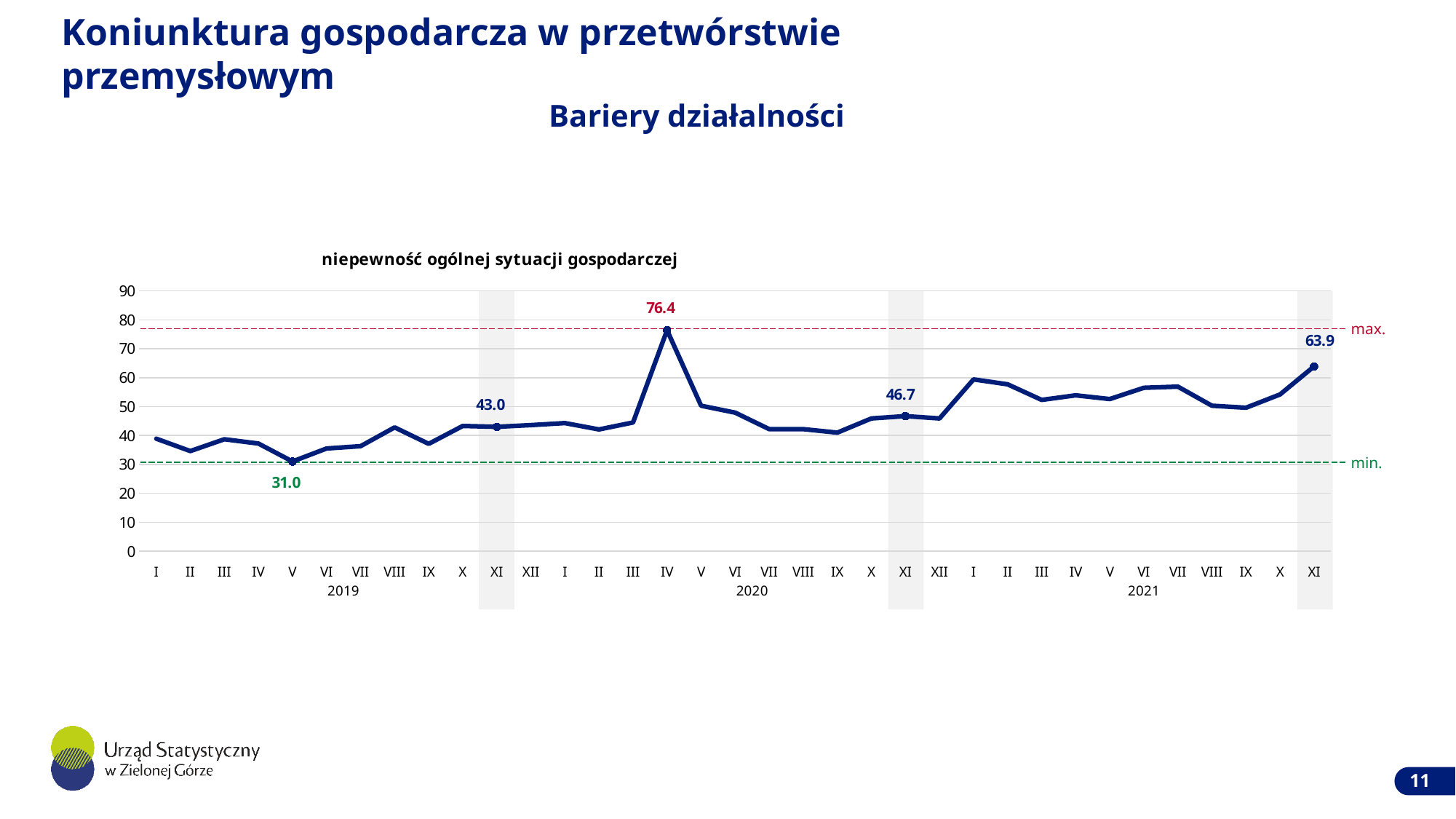
Which is larger, the value for XI 2019 or the value for XI 2020? XI 2020 What is the value for XI 2019? 43.0 What is the value for IV 2020? 76.4 What is the difference between the values for XI 2021 and XI 2020? 17.2 What is the value for V 2019? 31.0 What is the value for XI 2021? 63.9 Which month has the lowest value? V 2019 What type of chart is shown on the slide? line chart Which month has the highest value? IV 2020 Is the value for I 2021 greater or less than 50? greater What is the title of the chart? niepewność ogólnej sytuacji gospodarczej What is the value for XI 2020? 46.7